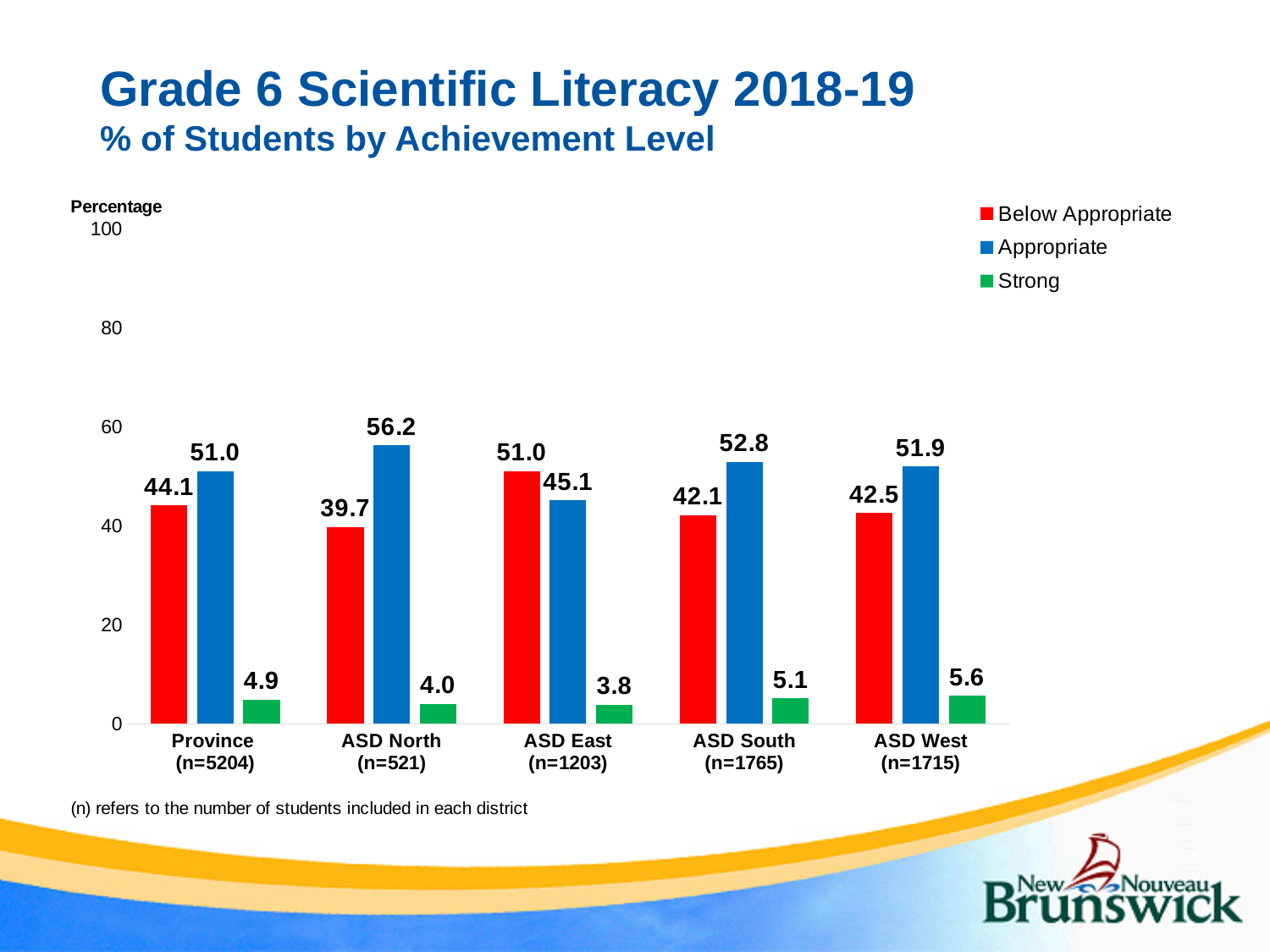
Which is larger for ASD East: Below Appropriate or Appropriate? Below Appropriate Which district has the highest Appropriate value? ASD North What kind of chart is shown on the slide? Bar chart What is the difference between the Appropriate and Below Appropriate values for ASD North? 16.5 Is the Below Appropriate value for Province greater or less than 40? greater How many series does the legend list? 3 Which category has the lowest Strong value? ASD East What is the Strong value for ASD West? 5.6 What is the Appropriate value for ASD North? 56.2 What is the number of students (n) for ASD South? 1765 What is the Below Appropriate value for ASD East? 51.0 How many categories are shown on the x axis? 5